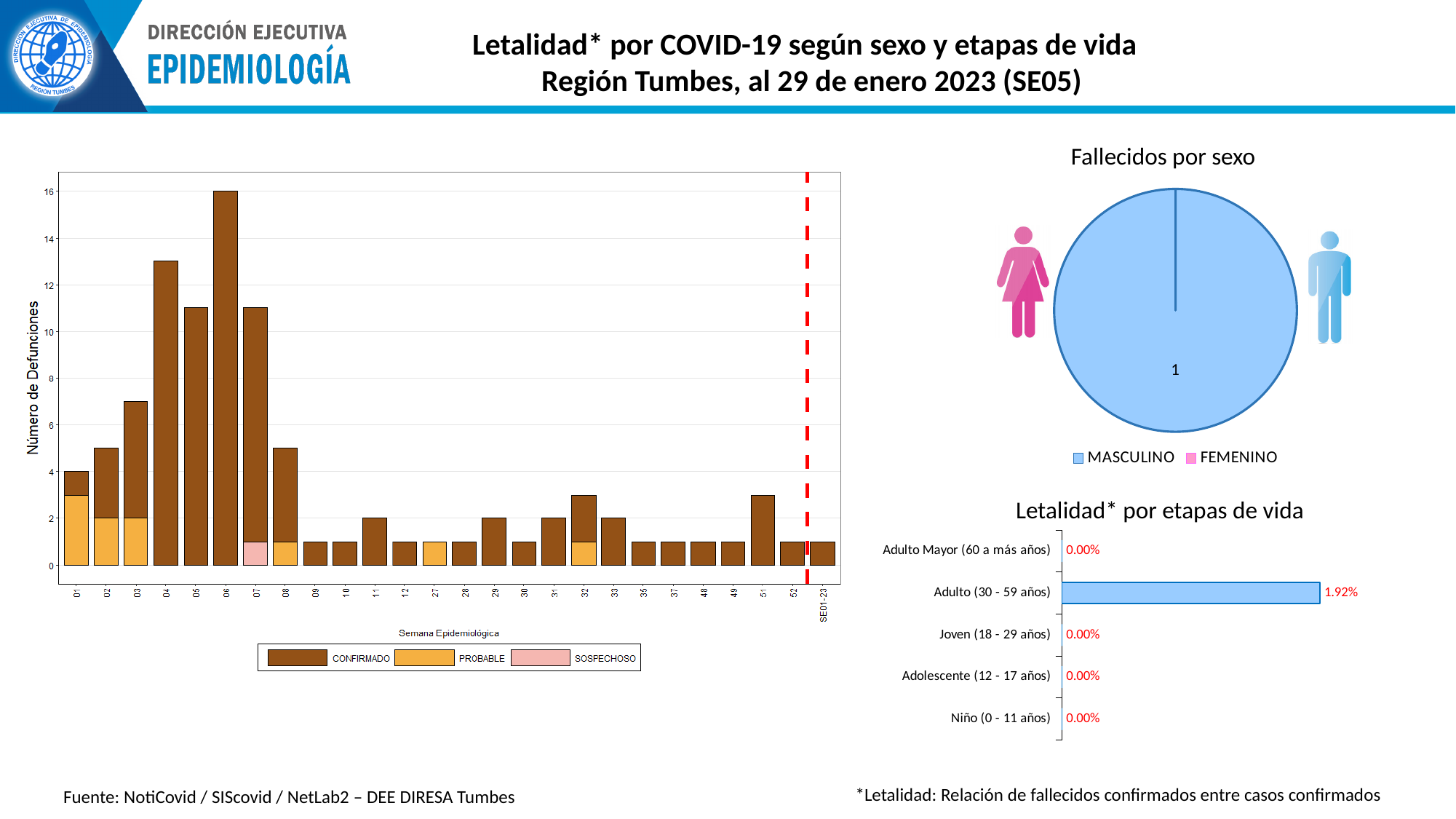
In the bar chart on the left, how many series does the legend list? 3 In the bar chart on the left, is the value for week 04 greater or less than 12? greater In the 'Letalidad* por etapas de vida' chart, which category has the highest value? Adulto (30 - 59 años) In the 'Fallecidos por sexo' chart, how many series does the legend list? 2 In the 'Letalidad* por etapas de vida' chart, what is the value for Adulto (30 - 59 años)? 1.92% In the bar chart on the left, what are the three legend entries? CONFIRMADO, PROBABLE, SOSPECHOSO In the bar chart on the left, which epidemiological week has the highest number of deaths? 06 What kind of chart is the 'Fallecidos por sexo' chart? pie chart In the 'Fallecidos por sexo' chart, what value is shown for MASCULINO? 1 In the bar chart on the left, what is the number of deaths for epidemiological week 06? 16 In the bar chart on the left, is the value for week 03 greater or less than 6? greater In the 'Letalidad* por etapas de vida' chart, how many categories are shown? 5